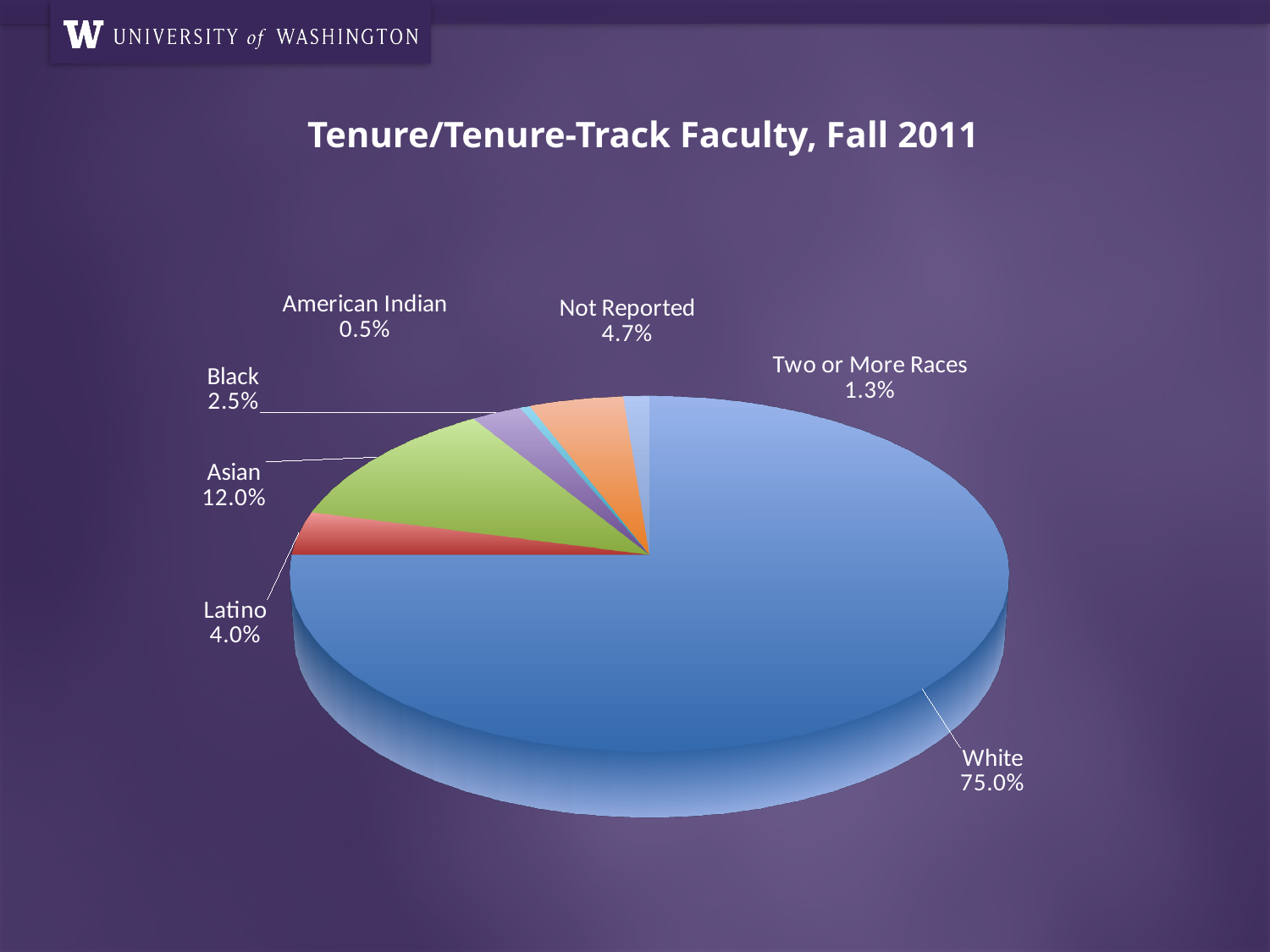
Which is larger, the share for Latino or the share for Black? Latino What percentage is shown for Not Reported? 4.7% Which category has the largest share of the pie? White What percentage of tenure/tenure-track faculty is Asian? 12.0% How many categories are shown in the pie chart? 7 Which category has the smallest share of the pie? American Indian What percentage of tenure/tenure-track faculty is White? 75.0% What is the combined percentage of Black and Two or More Races? 3.8% What percentage of faculty is Latino? 4.0% What is the difference in percentage points between the Asian and Black shares? 9.5 What type of chart is shown on the slide? Pie chart What is the title of the chart? Tenure/Tenure-Track Faculty, Fall 2011